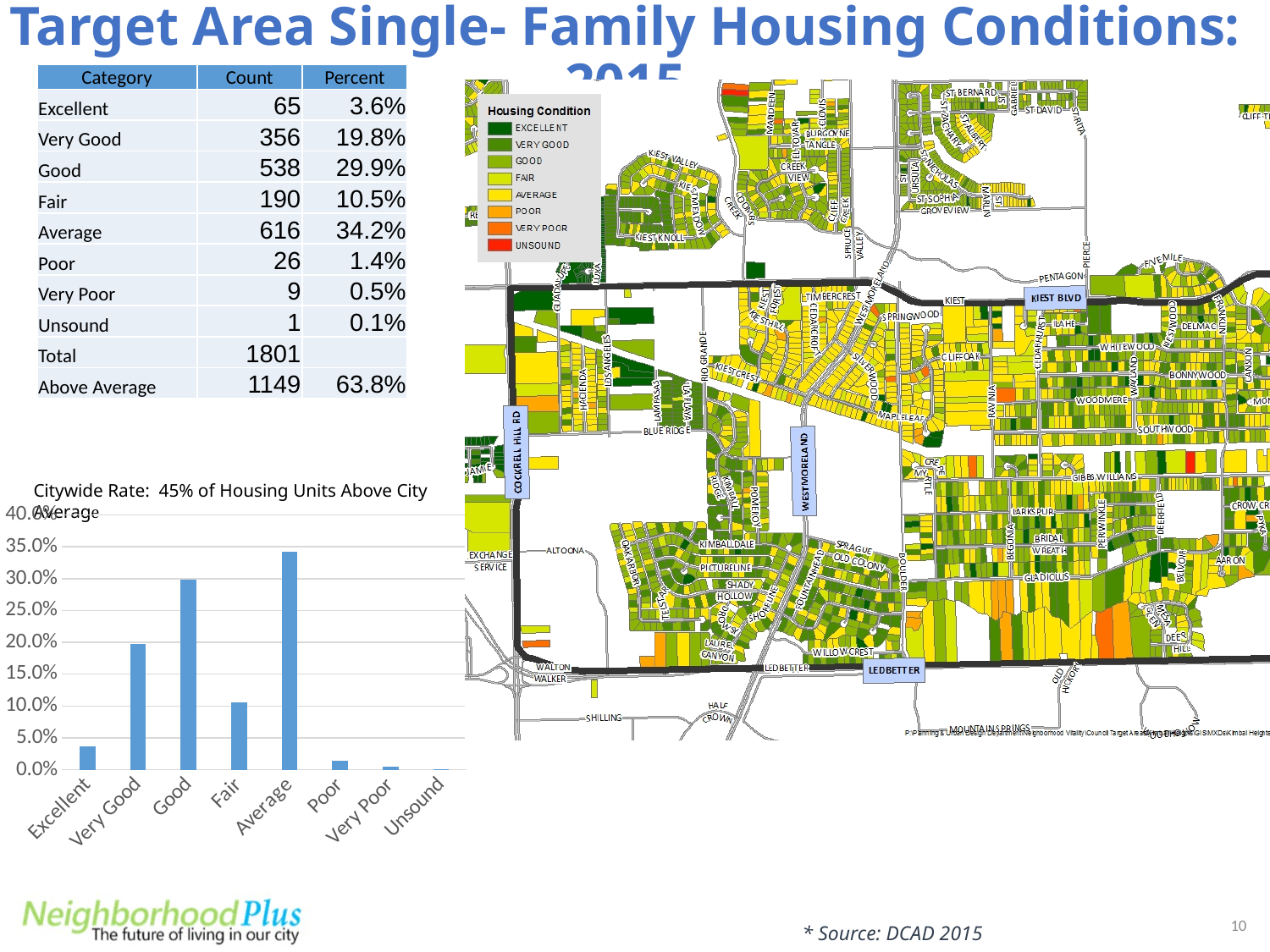
Is the value for Good greater or less than 25.0%? greater What type of chart is shown on the slide? bar chart Which is larger, the value for Very Good or the value for Fair? Very Good Which category has the lowest value in the chart? Unsound What is the difference between the Average value and the Good value? 4.3% How many categories are plotted on the bar chart? 8 What is the percent value for the Excellent category? 3.6% What is the percent value for the Average category? 34.2% What is the highest tick shown on the chart's vertical axis? 40.0% Is the value for Fair greater or less than 15.0%? less What is the percent value for the Good category? 29.9% Which category has the highest bar in the chart? Average